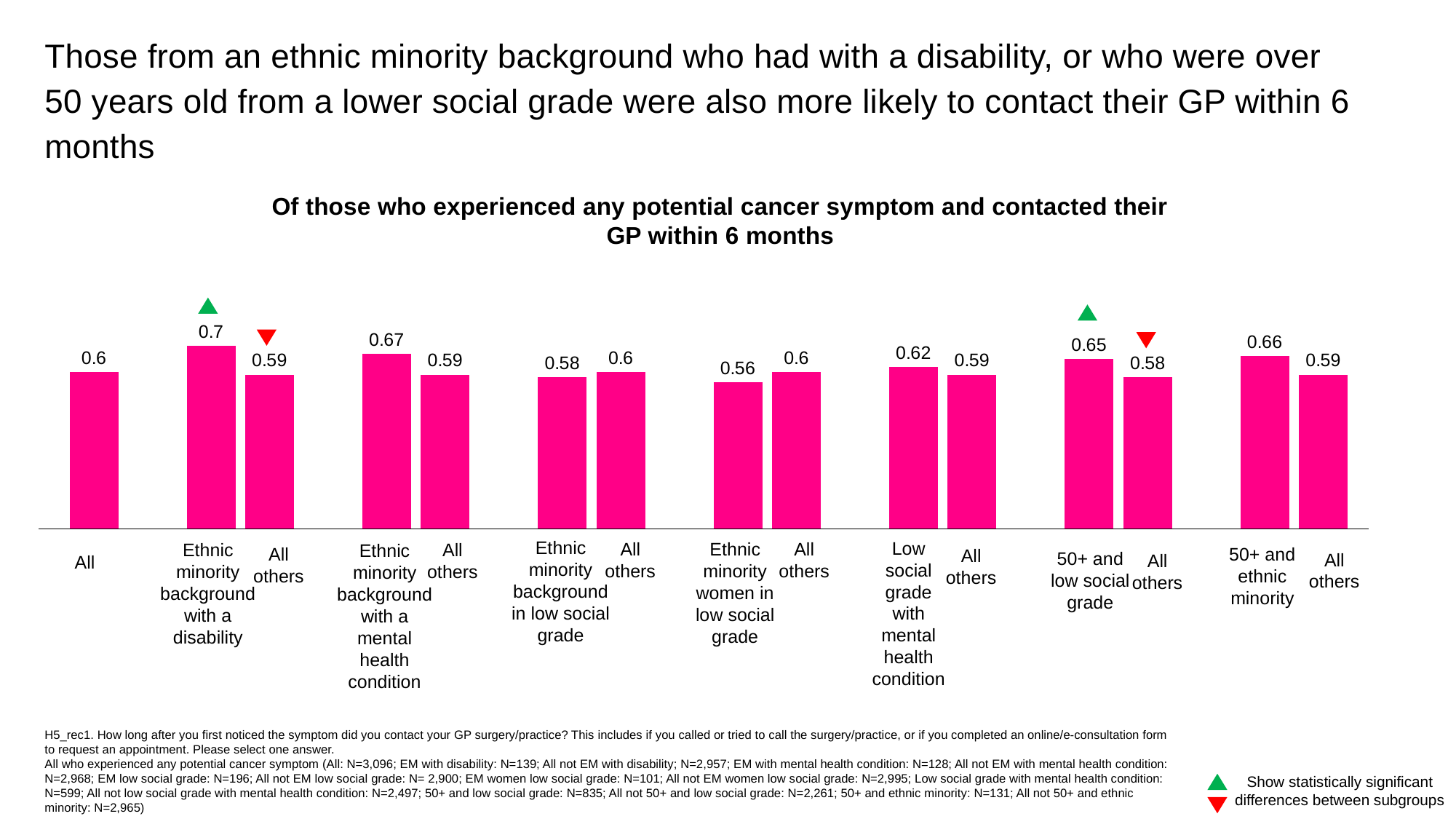
What is the difference between "50+ and ethnic minority" and the "All others" bar next to it? 0.07 What is the value for the "All" bar? 0.6 What is the difference between "Ethnic minority background with a disability" (0.7) and the "All others" bar next to it (0.59)? 0.11 What is the value for "Ethnic minority background with a disability"? 0.7 What is the value for "Ethnic minority women in low social grade"? 0.56 Which is larger: the value for "Ethnic minority background in low social grade" or the "All others" bar next to it? All others What type of chart is shown on the slide? Bar chart What is the value for "50+ and low social grade"? 0.65 Which category has the highest value in the chart? Ethnic minority background with a disability How many bars are plotted in the chart? 15 What is the value for "Ethnic minority background with a mental health condition"? 0.67 Which category has the lowest value in the chart? Ethnic minority women in low social grade